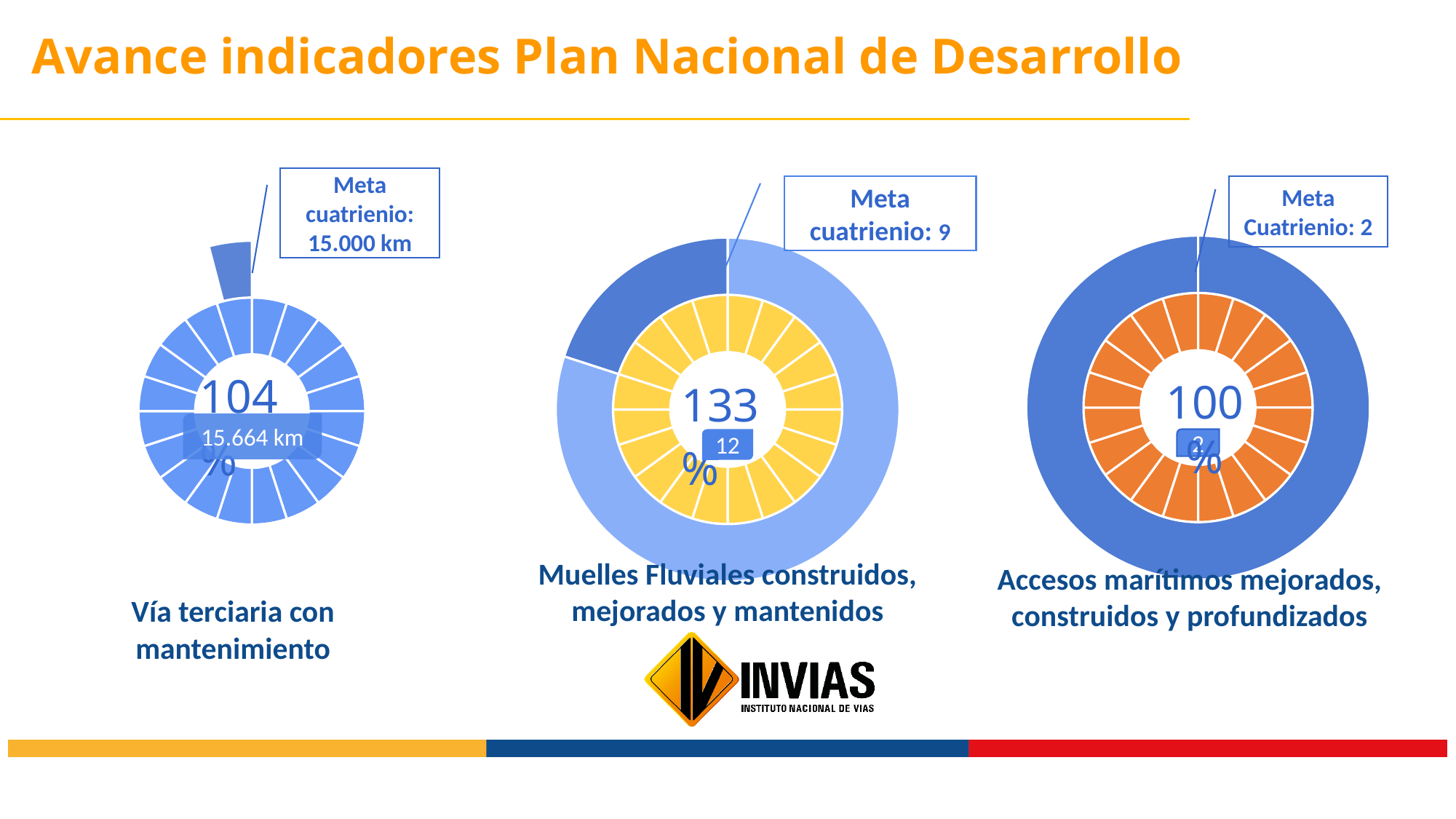
On the 'Muelles Fluviales' chart, what is the 'Meta cuatrienio' target? 9 Which of the three indicators shows the highest percentage of progress? Muelles Fluviales construidos, mejorados y mantenidos On the 'Muelles Fluviales' chart, what achieved value is shown in the centre label? 12 Which of the three indicators shows the lowest percentage of progress? Accesos marítimos mejorados, construidos y profundizados On the 'Vía terciaria con mantenimiento' chart, what percentage of progress is shown in the centre? 104% On the 'Muelles Fluviales' chart, by how much does the achieved value (12) exceed the target (9)? 3 On the 'Vía terciaria con mantenimiento' chart, what is the 'Meta cuatrienio' target? 15.000 km On the 'Muelles Fluviales construidos, mejorados y mantenidos' chart, what percentage of progress is shown in the centre? 133% How many charts are shown on the slide? 3 On the 'Accesos marítimos' chart, what is the 'Meta Cuatrienio' target? 2 On the 'Accesos marítimos mejorados, construidos y profundizados' chart, what percentage of progress is shown in the centre? 100% On the 'Vía terciaria con mantenimiento' chart, how many km are shown as achieved? 15.664 km